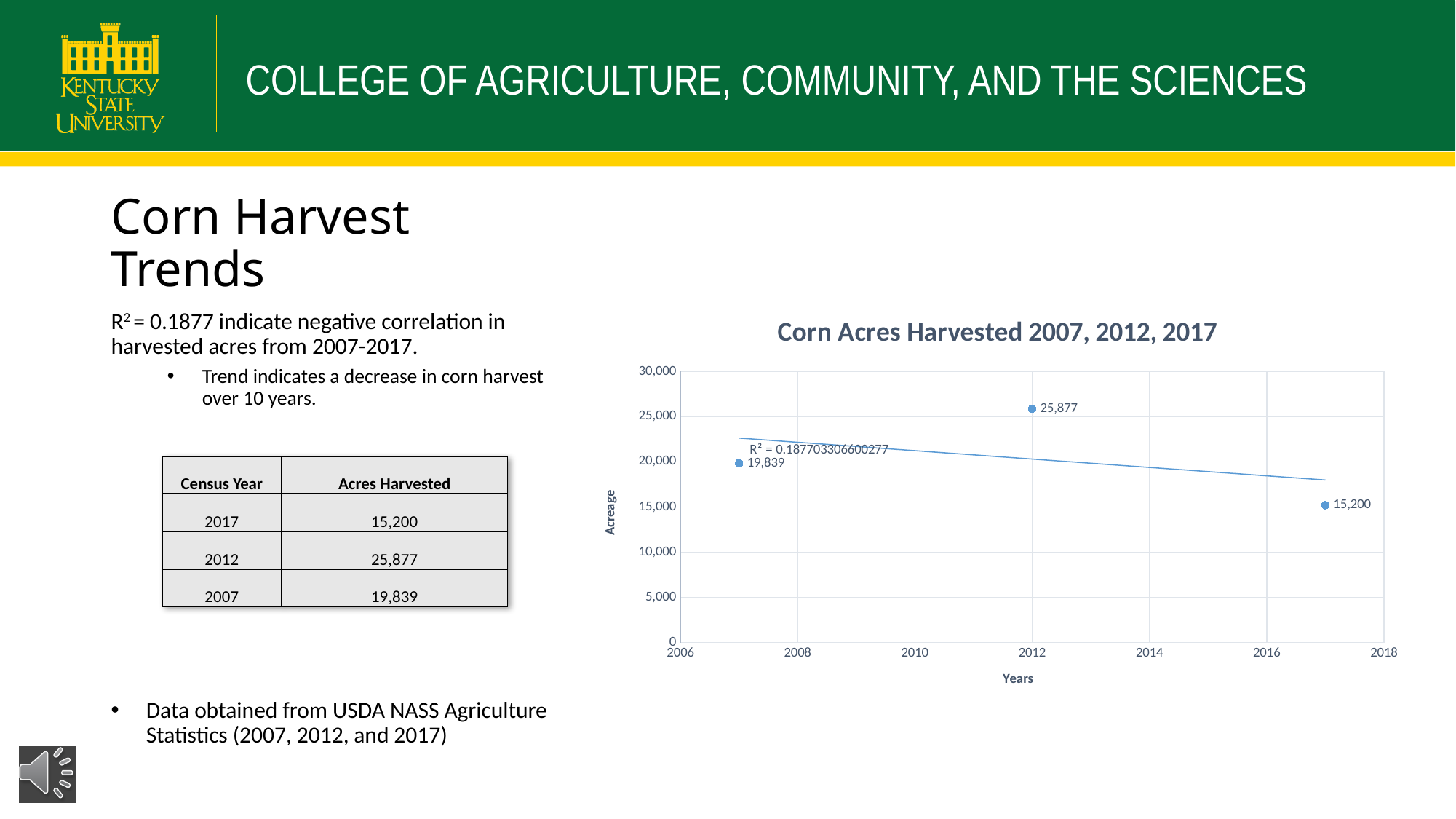
Is the value for 2012 greater or less than 25,000? greater What is the label on the y axis of the chart? Acreage Which year has the lowest acreage harvested? 2017 What is the acreage value plotted for 2012? 25,877 What is the acreage value plotted for 2017? 15,200 What kind of chart is shown on the slide? scatter chart What is the difference in acreage between 2012 and 2017? 10,677 What is the title of the chart? Corn Acres Harvested 2007, 2012, 2017 How many data points are plotted in the chart? 3 Which year has the larger acreage, 2007 or 2017? 2007 What is the acreage value plotted for 2007? 19,839 Which year has the highest acreage harvested? 2012